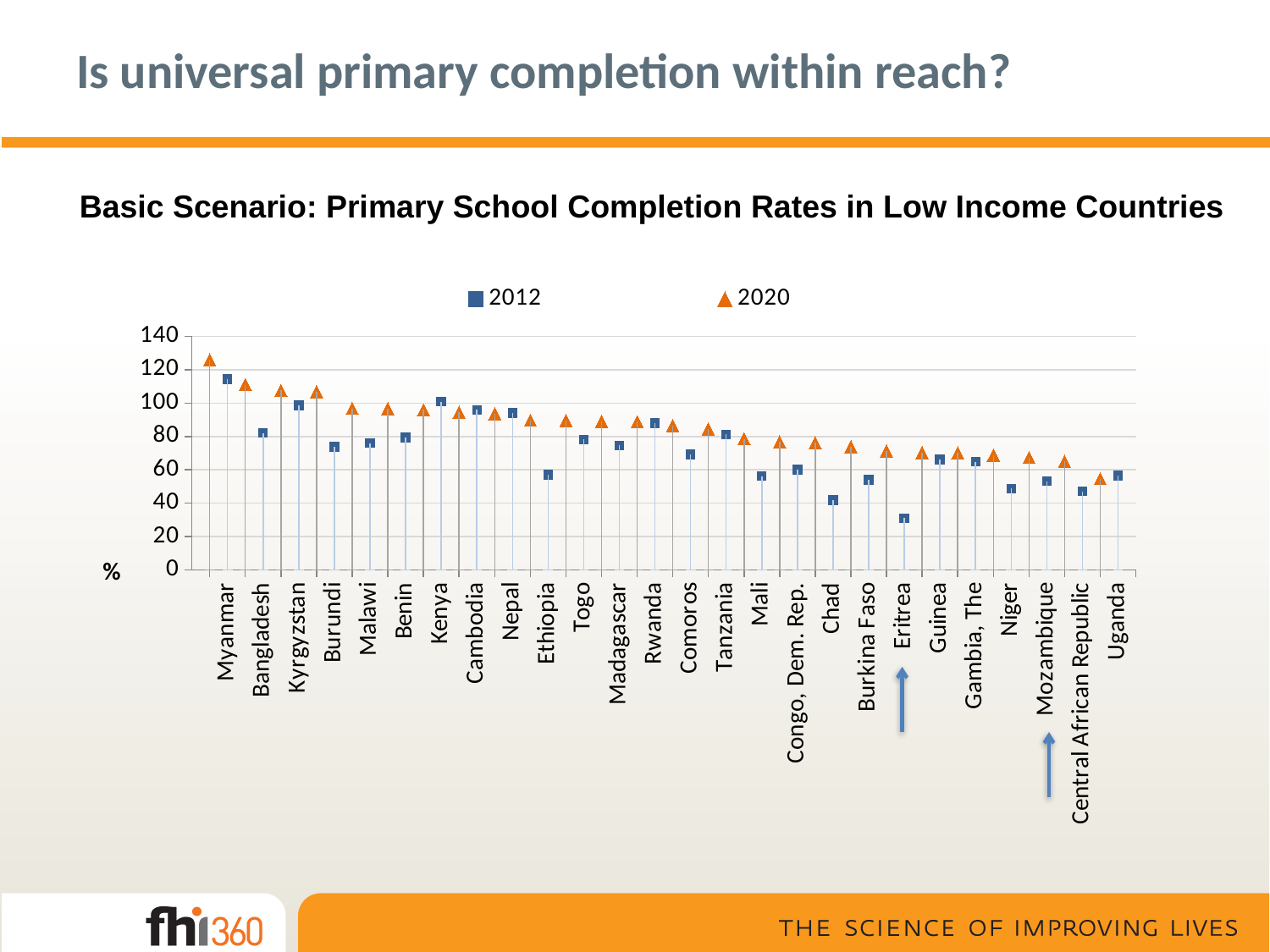
Which country has the highest 2020 value? Myanmar How many series does the legend list? 2 Is the 2012 value for Burundi greater or less than 80? less Do the 2020 values generally rise or fall moving from left to right along the x axis? fall Which is larger: the 2012 value for Myanmar or the 2012 value for Uganda? Myanmar Is the 2012 value for Central African Republic greater or less than 60? less What are the two series shown in the legend? 2012 and 2020 How many countries are shown on the x axis? 26 Which country has the lowest 2012 value? Eritrea For Eritrea, which is larger: the 2012 value or the 2020 value? 2020 Is the 2012 value for Eritrea greater or less than 40? less